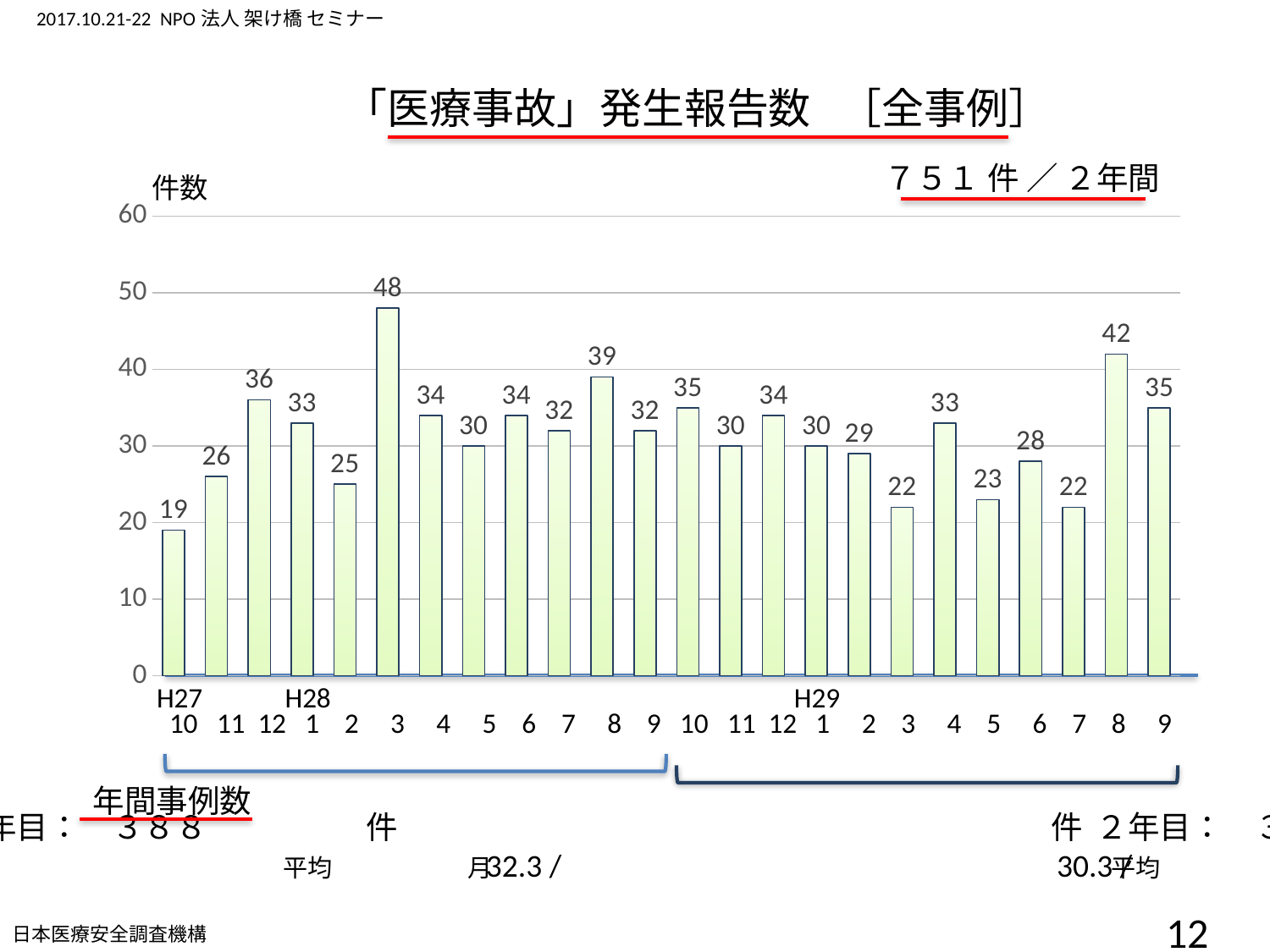
How many monthly bars are plotted in the chart? 24 What is the value for H27 October (10)? 19 Is the value for H29 March greater or less than 30? less What is the value for H28 March (3)? 48 Which month has the highest value in the chart? H28 3 What is the difference between the values for H28 March (48) and H27 October (19)? 29 What is the difference between the values for H29 August and H29 July? 20 Which month has the lowest value in the chart? H27 10 Which is larger, the value for H28 August or the value for H29 August? H29 August What is the label shown on the vertical axis of the chart? 件数 What type of chart is shown on the slide? bar chart What is the value for H29 August (8)? 42